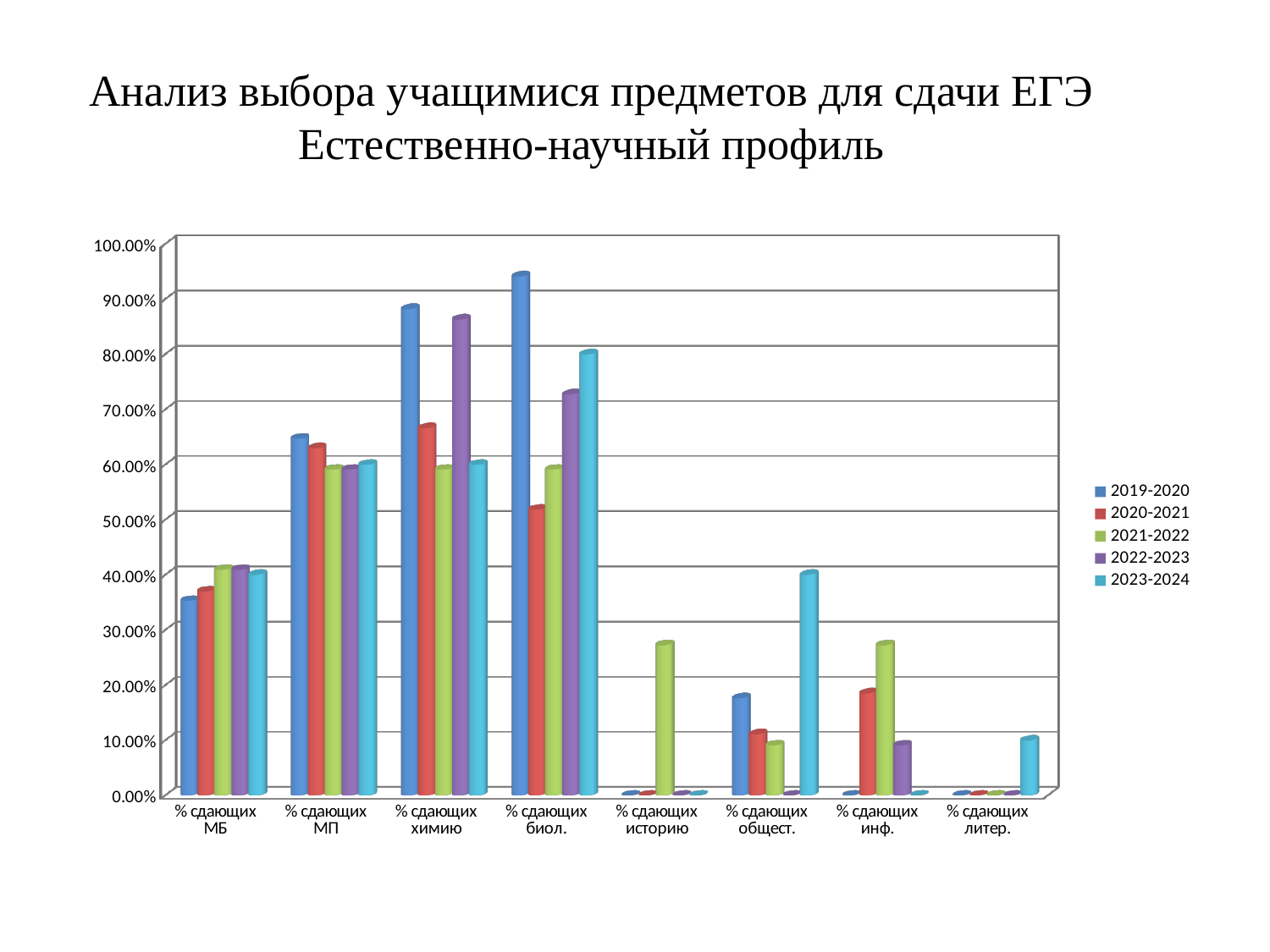
Is the 2019-2020 value for % сдающих химию greater or less than 80%? greater Is the 2021-2022 value for % сдающих историю greater or less than 20%? greater For % сдающих биол., which is larger: the 2022-2023 value or the 2023-2024 value? 2023-2024 How many series does the legend list? 5 For % сдающих химию, which is larger: the 2019-2020 value or the 2020-2021 value? 2019-2020 For % сдающих биол., which series has the lowest value? 2020-2021 Is the 2023-2024 value for % сдающих литер. greater or less than 20%? less What kind of chart is shown on the slide? bar chart How many categories are shown along the x axis? 8 Which category has the highest value for the 2019-2020 series? % сдающих биол. What is the first entry listed in the legend? 2019-2020